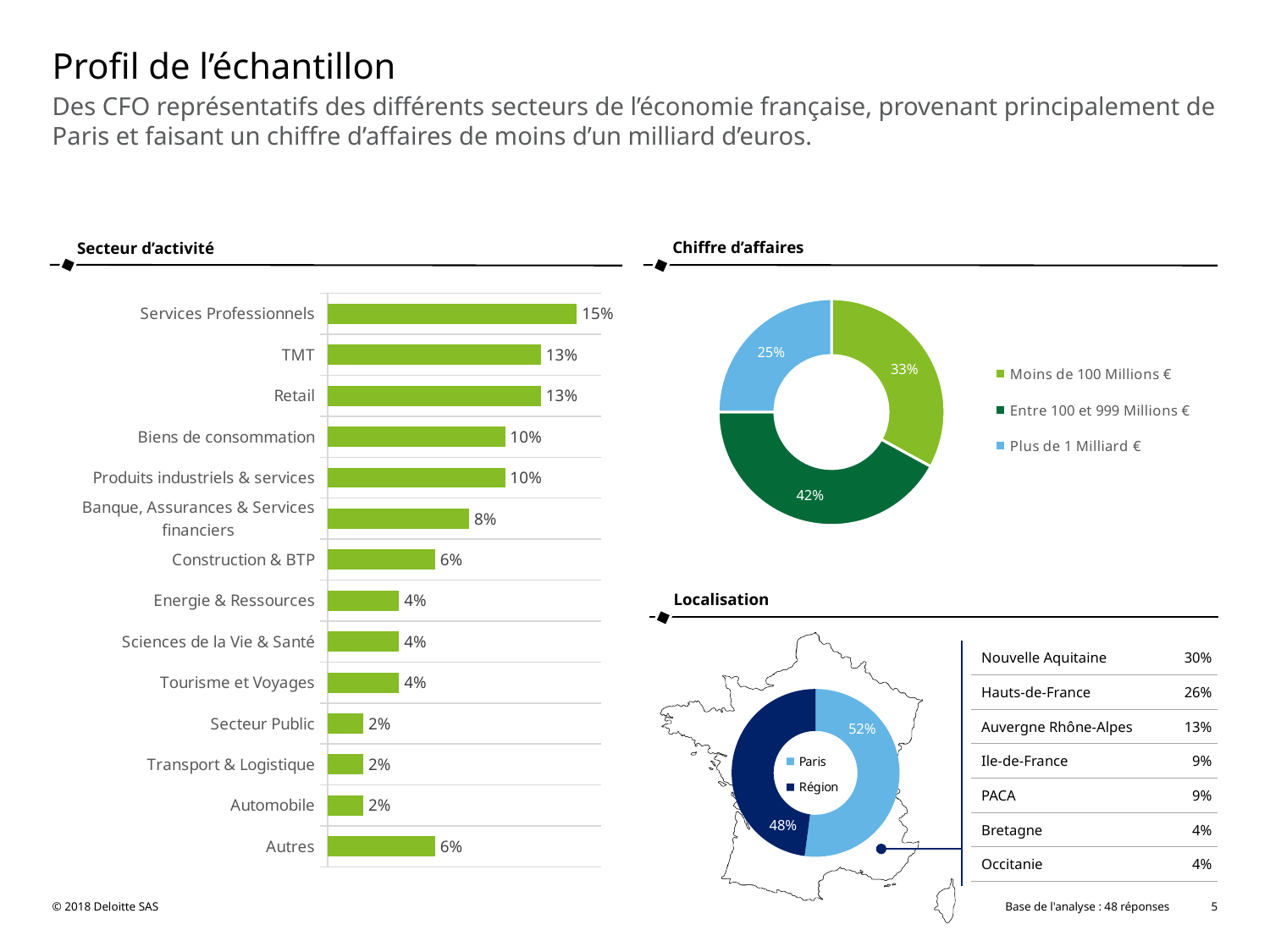
How many categories are shown in the 'Secteur d'activité' chart? 14 In the 'Chiffre d'affaires' chart, which category has the smallest share? Plus de 1 Milliard € In the 'Secteur d'activité' chart, what is the value for Services Professionnels? 15% In the 'Secteur d'activité' chart, what is the value for Construction & BTP? 6% How many series does the legend of the 'Chiffre d'affaires' chart list? 3 In the 'Secteur d'activité' chart, which is larger: Biens de consommation or Energie & Ressources? Biens de consommation What kind of chart is the 'Secteur d'activité' chart? Bar chart In the 'Secteur d'activité' chart, what is the difference between TMT and Banque, Assurances & Services financiers? 5% In the 'Secteur d'activité' chart, which category has the highest value? Services Professionnels In the 'Localisation' chart, what share is Paris? 52% In the 'Localisation' chart, what is the difference between Paris and Région? 4% In the 'Chiffre d'affaires' chart, what share is 'Entre 100 et 999 Millions €'? 42%